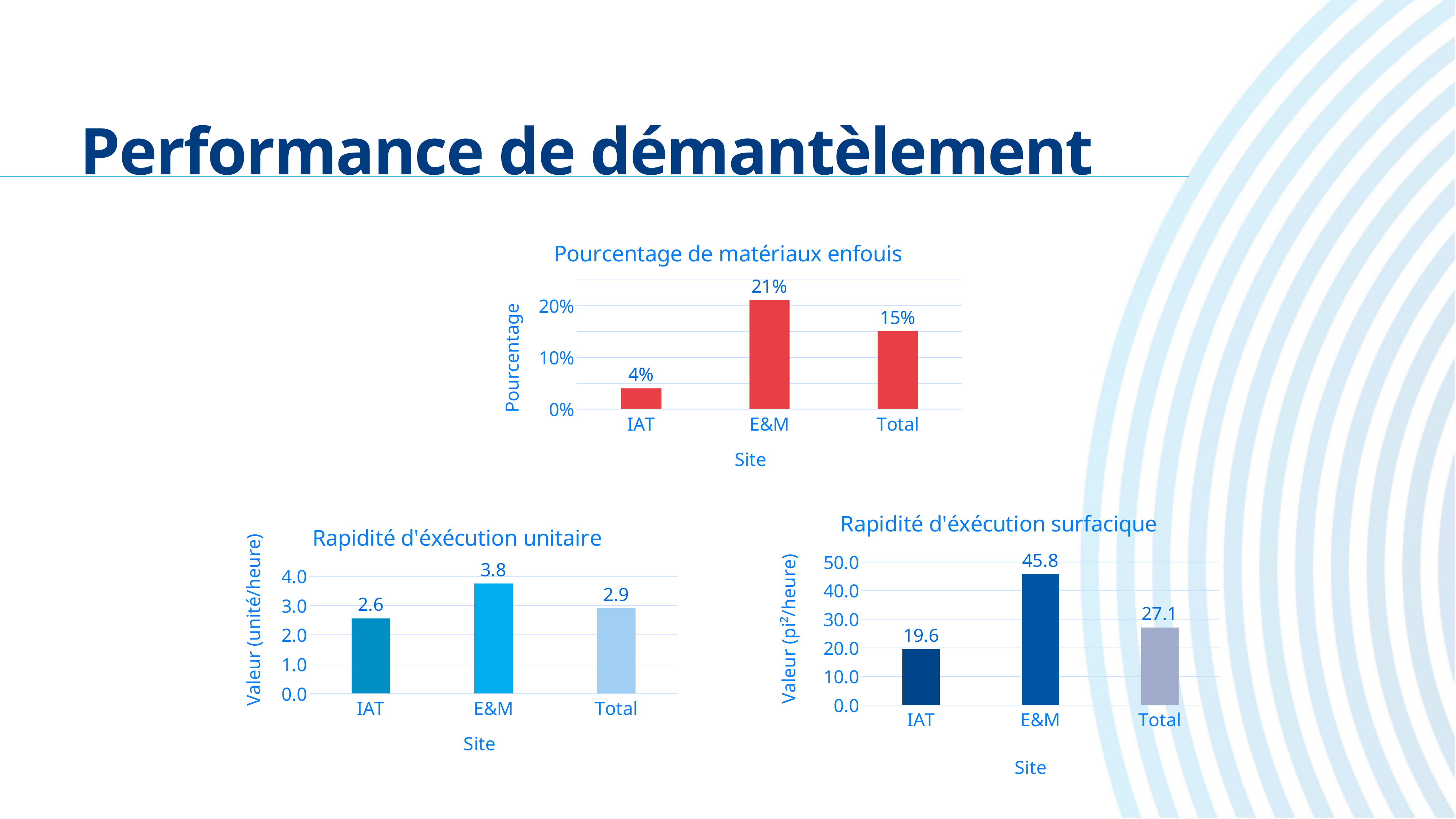
In the chart titled "Rapidité d'éxécution unitaire", what kind of chart is shown? bar chart In the chart titled "Rapidité d'éxécution unitaire", is the value for Total larger or smaller than the value for IAT? larger In the chart titled "Rapidité d'éxécution surfacique", what is the difference between the E&M value and the IAT value? 26.2 In the chart titled "Rapidité d'éxécution unitaire", what is the value for IAT? 2.6 In the chart titled "Rapidité d'éxécution surfacique", is the value for IAT greater or less than 20.0? less In the chart titled "Pourcentage de matériaux enfouis", what is the value for E&M? 21% In the chart titled "Pourcentage de matériaux enfouis", which site has the lowest value? IAT In the chart titled "Pourcentage de matériaux enfouis", how many categories are shown on the x axis? 3 In the chart titled "Rapidité d'éxécution unitaire", which site has the highest value? E&M In the chart titled "Pourcentage de matériaux enfouis", what is the difference between the E&M value and the IAT value? 17% In the chart titled "Rapidité d'éxécution surfacique", what is the label of the y axis? Valeur (pi²/heure) In the chart titled "Rapidité d'éxécution surfacique", what is the value for Total? 27.1